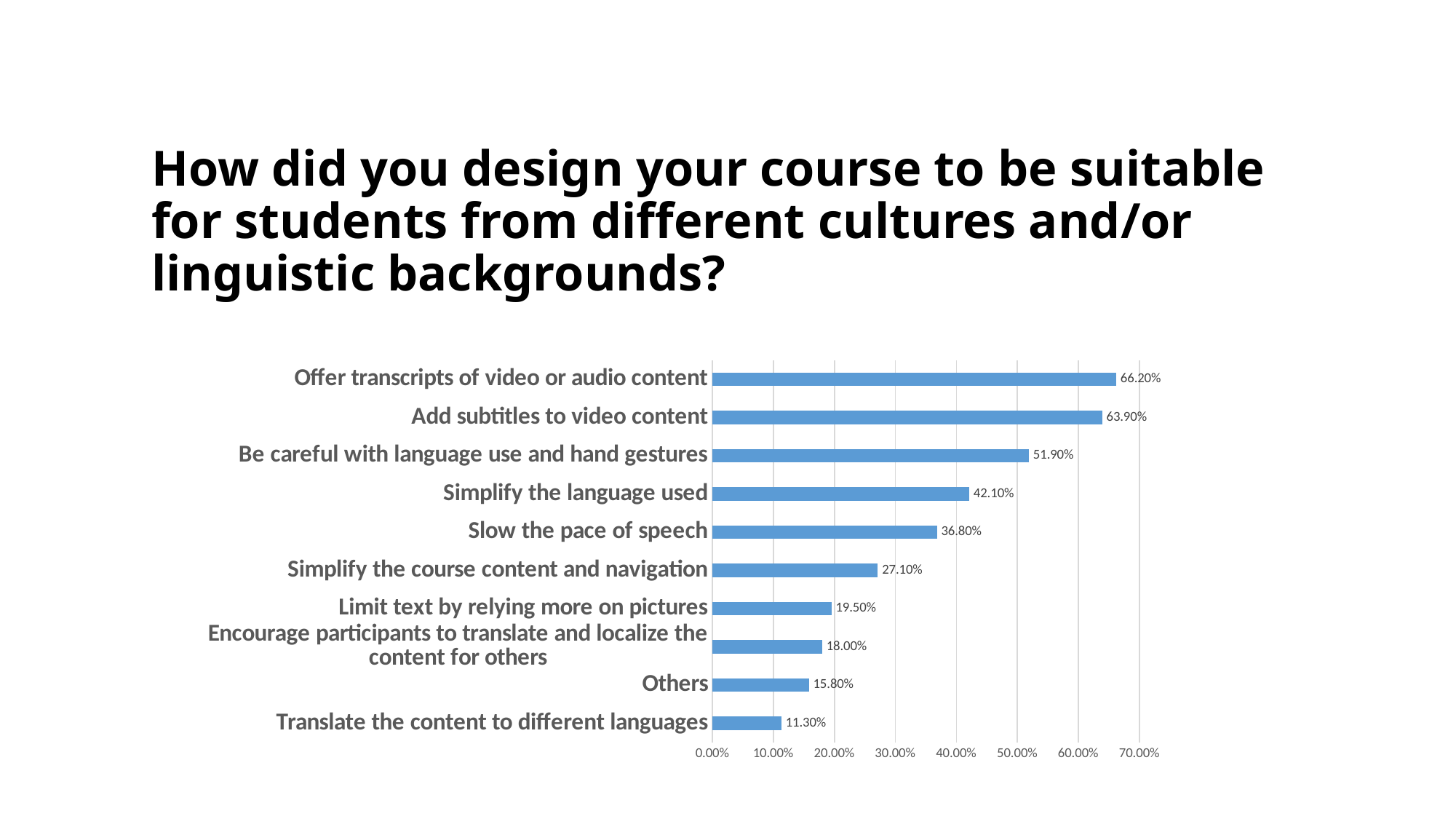
How many categories are shown in the chart? 10 What is the difference between "Add subtitles to video content" and "Simplify the language used"? 21.80% Which category has the lowest value? Translate the content to different languages What is the value for "Slow the pace of speech"? 36.80% What is the value for "Others"? 15.80% Which is larger: "Simplify the course content and navigation" or "Limit text by relying more on pictures"? Simplify the course content and navigation What percentage of respondents said they offer transcripts of video or audio content? 66.20% What kind of chart is shown on the slide? Bar chart Which category has the highest value? Offer transcripts of video or audio content What is the highest value shown on the x axis? 70.00% What is the value for "Translate the content to different languages"? 11.30% Is the value for "Be careful with language use and hand gestures" greater or less than 50.00%? greater